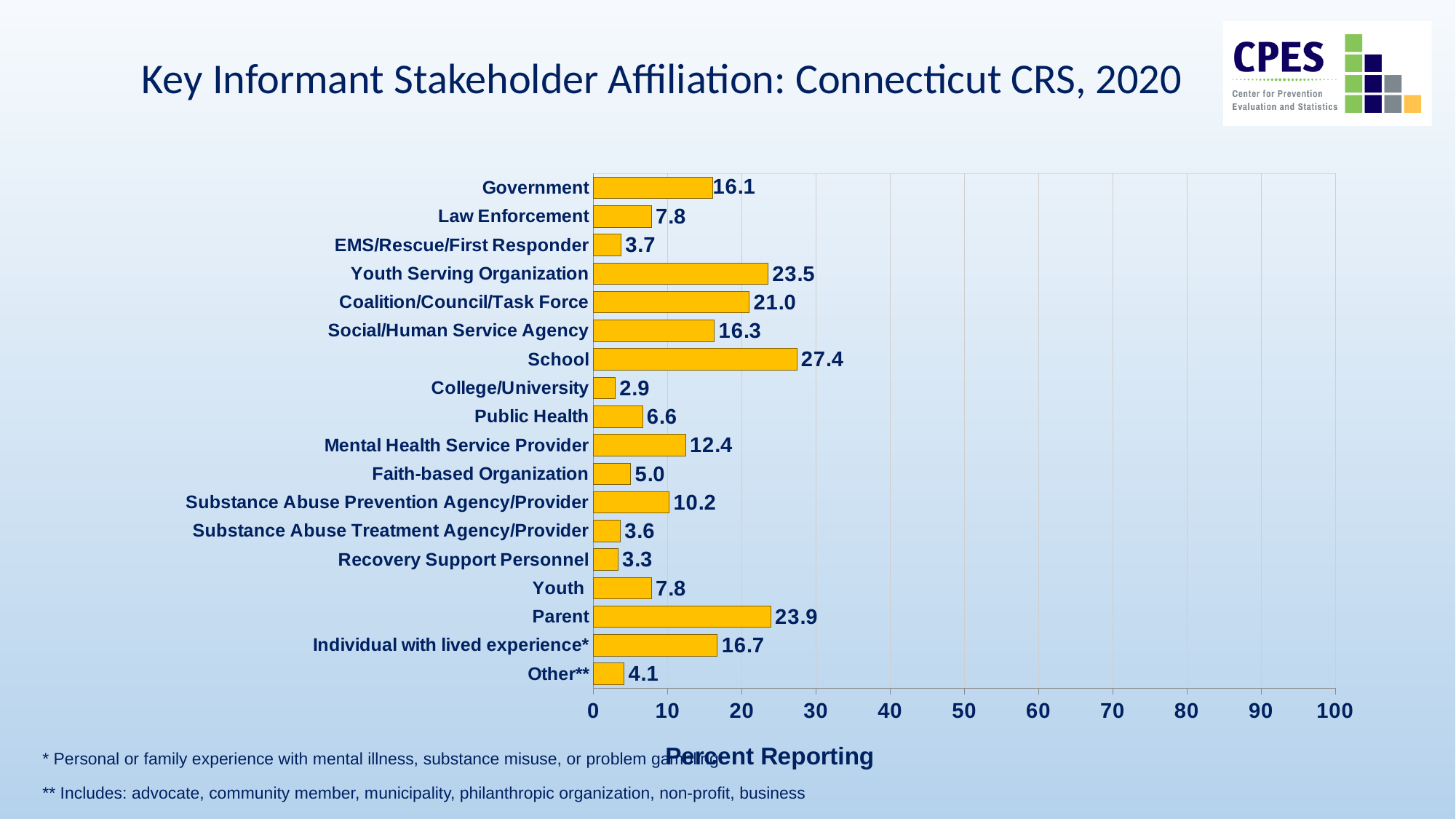
How many categories are shown in the chart? 18 Is the value for Individual with lived experience* greater or less than 20? less Which category has the highest value? School What kind of chart is shown on the slide? bar chart What is the value for Mental Health Service Provider? 12.4 Which category has the lowest value? College/University What is the label of the x axis? Percent Reporting What is the value for Parent? 23.9 What is the difference between the values for Youth Serving Organization and Coalition/Council/Task Force? 2.5 What is the value for School? 27.4 What is the title of the slide? Key Informant Stakeholder Affiliation: Connecticut CRS, 2020 Which is larger, the value for Government or the value for Social/Human Service Agency? Social/Human Service Agency